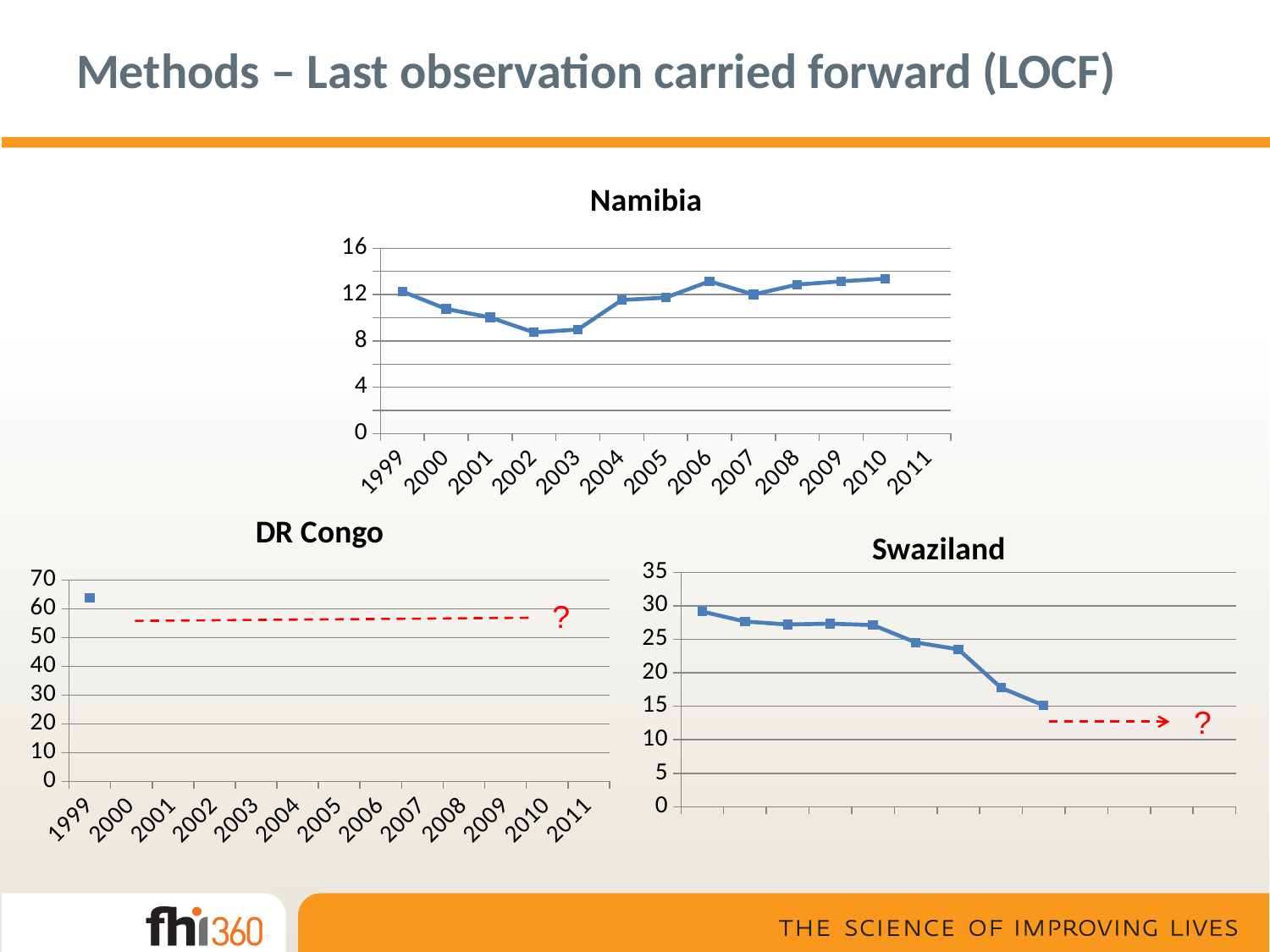
In the DR Congo chart, how many data points are plotted? 1 In the Swaziland chart, is the last plotted value greater or less than 20? less In the Namibia chart, how many years on the x axis have a plotted data point? 12 In the Namibia chart, which is larger, the value for 1999 or the value for 2002? 1999 How many charts are shown on the slide? 3 In the Namibia chart, is the value for 2006 greater or less than 12? greater In the Namibia chart, which year has the lowest value? 2002 In the DR Congo chart, is the value for 1999 greater or less than 60? greater What type of chart is the Namibia chart? line chart In the Swaziland chart, do the values generally rise or fall from left to right? fall